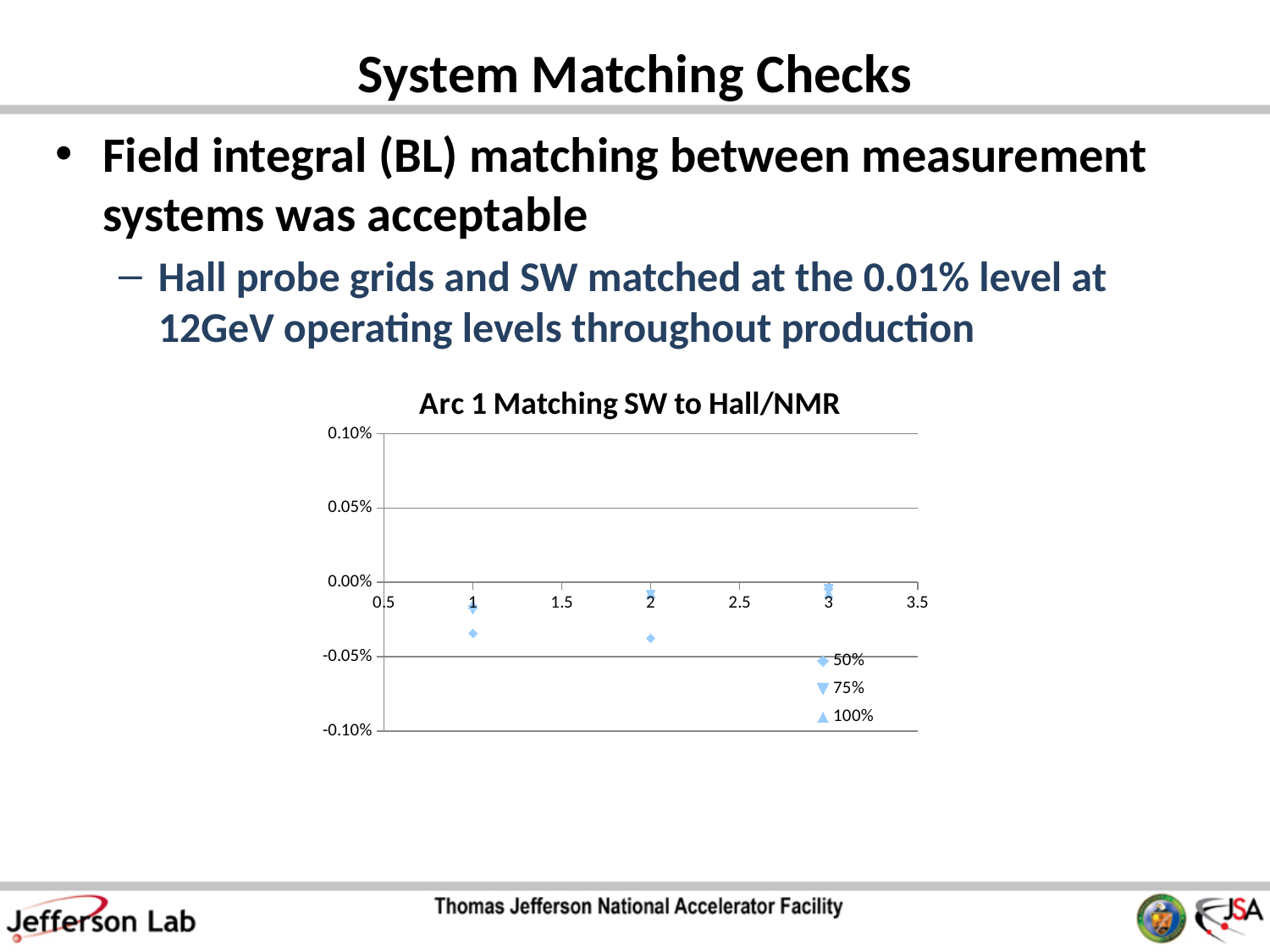
What kind of chart is shown on the slide? scatter chart What are the series names listed in the chart legend? 50%, 75%, 100% Is the value of the 50% series at x = 2 greater or less than -0.05%? greater Is the value of the 50% series at x = 1 greater or less than 0.00%? less For the 50% series, is the value at x = 3 higher or lower than the value at x = 2? higher At x = 2, which series has the higher value, 50% or 75%? 75% What is the highest value shown on the vertical axis of the chart? 0.10% Is the value of the 75% series at x = 1 greater or less than -0.05%? greater How many series does the chart legend list? 3 What is the title of the chart? Arc 1 Matching SW to Hall/NMR At x = 1, which series has the lower value, 50% or 75%? 50%